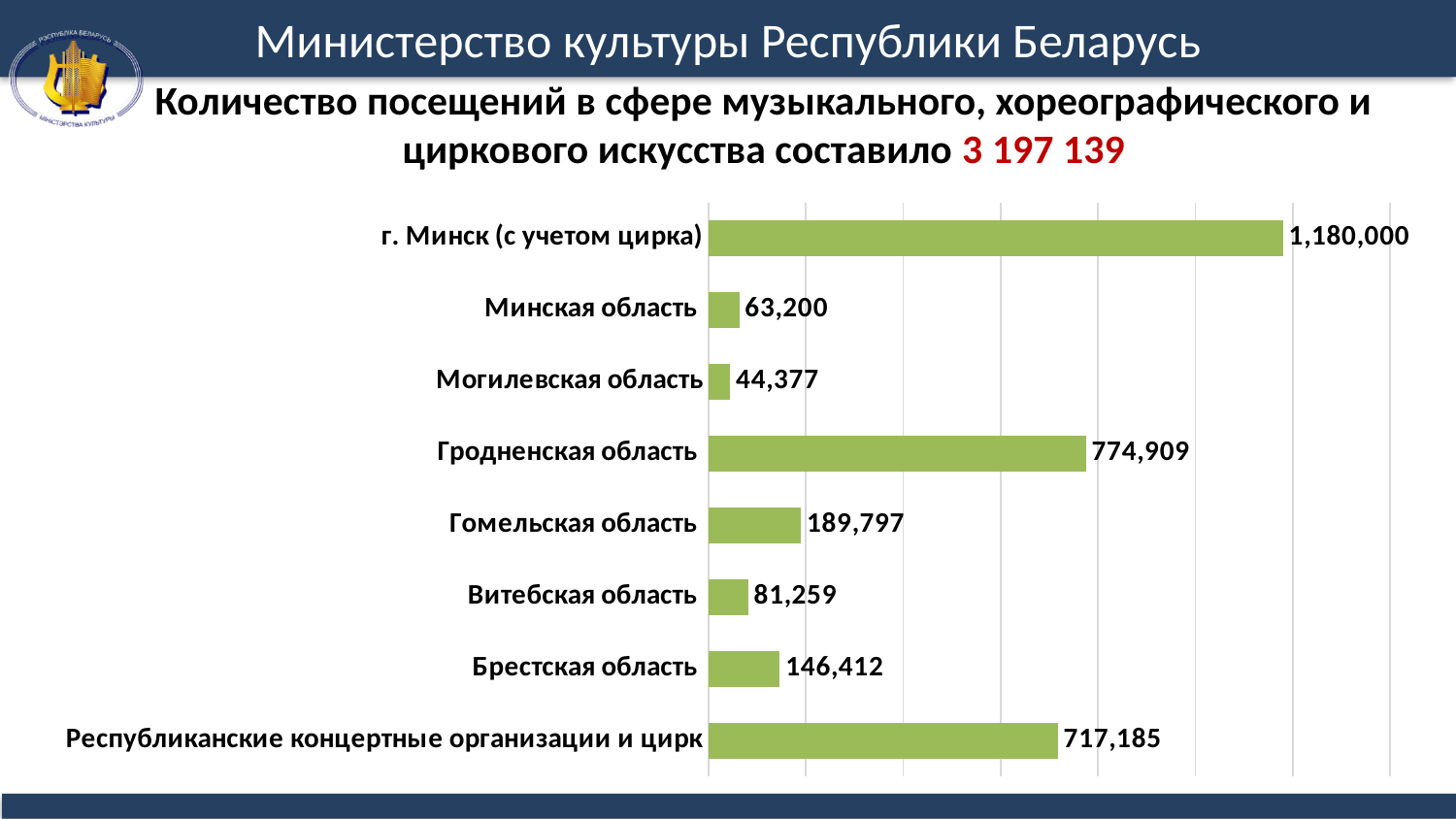
What kind of chart is shown on the slide? bar chart What is the difference between the values for Минская область and Могилевская область? 18,823 What total number of visits is stated in the slide title? 3 197 139 What is the value for Республиканские концертные организации и цирк? 717,185 Which category has the highest value? г. Минск (с учетом цирка) How many categories are shown in the chart? 8 What is the value for Гродненская область? 774,909 Which category has the lowest value? Могилевская область What is the value for Витебская область? 81,259 Which is larger, the value for Гродненская область or the value for Республиканские концертные организации и цирк? Гродненская область What is the difference between the values for Гомельская область and Брестская область? 43,385 What is the value for г. Минск (с учетом цирка)? 1,180,000